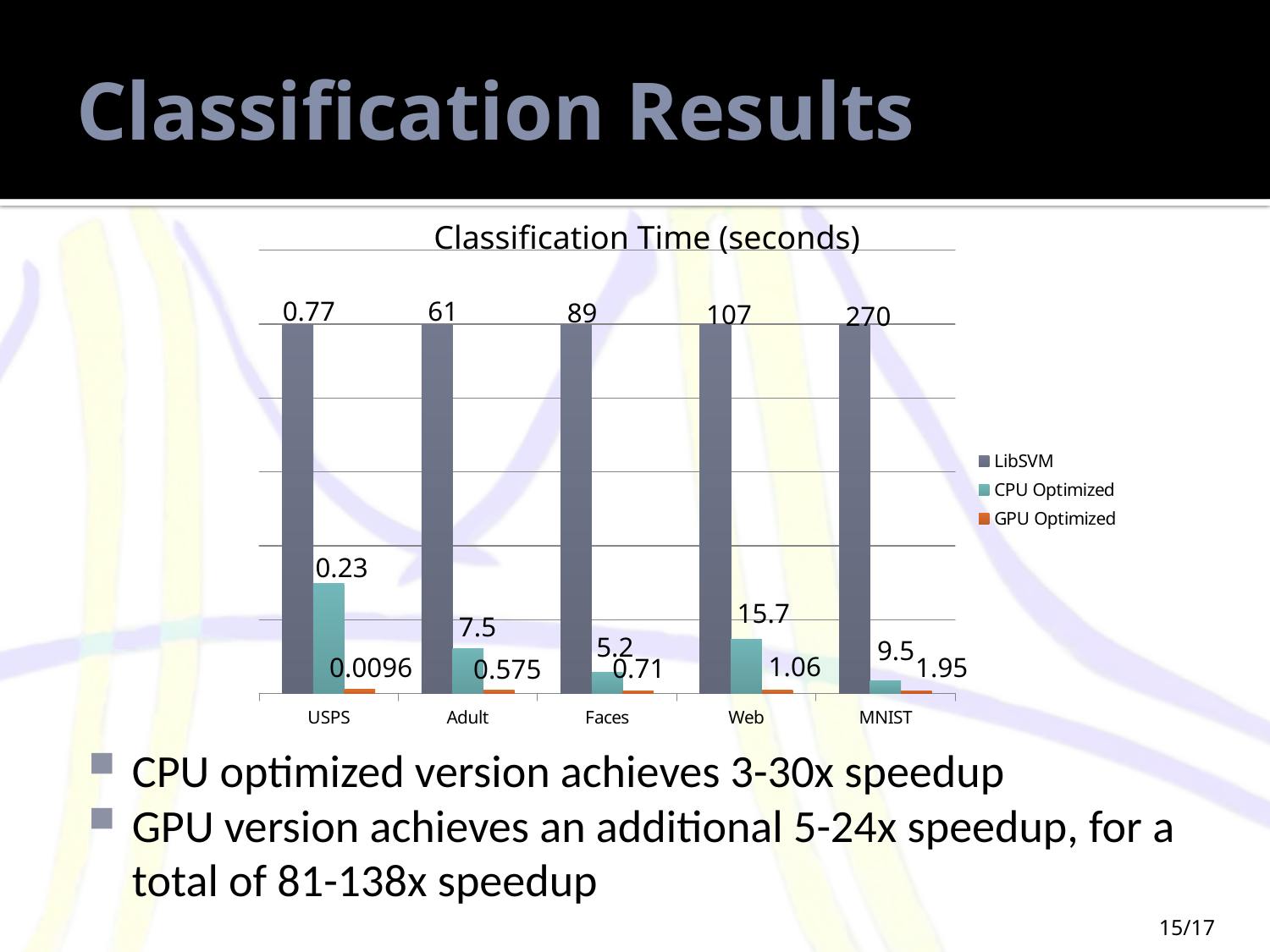
What is the GPU Optimized value for the Adult dataset? 0.575 What kind of chart is shown on the slide? Bar chart What is the difference between the LibSVM times for Faces and Adult? 28 What is the CPU Optimized classification time for Web? 15.7 Which dataset has the highest LibSVM classification time? MNIST Which dataset has the highest GPU Optimized classification time? MNIST What is the LibSVM classification time for the MNIST dataset? 270 Which dataset has the lowest CPU Optimized classification time? USPS What is the GPU Optimized classification time for USPS? 0.0096 Which is larger, the CPU Optimized time for Adult or for Faces? Adult How many series does the legend list? 3 How many datasets are shown on the x axis? 5